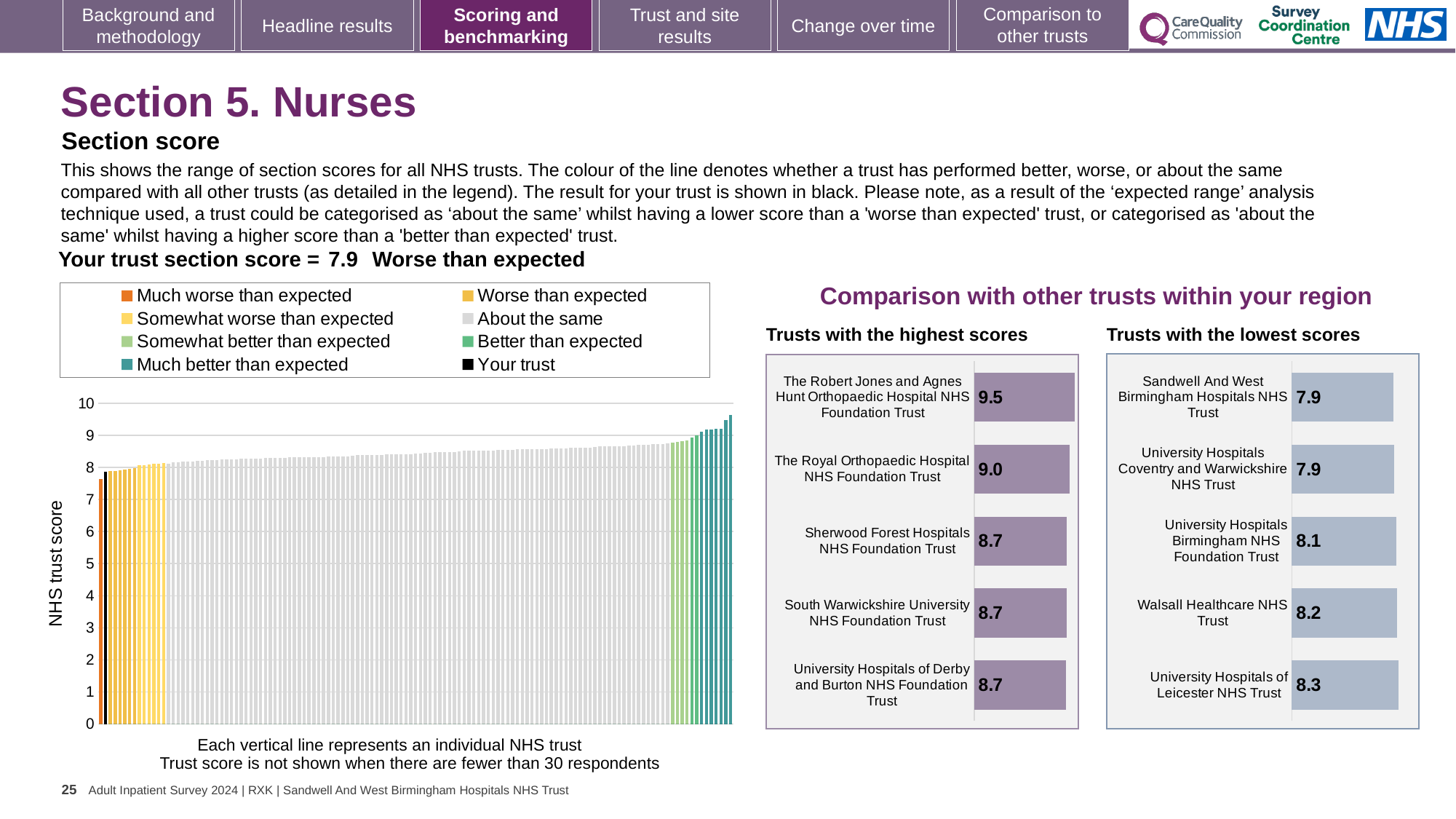
How many entries does the legend above the large chart on the left list? 8 In the large chart on the left, do the trust scores rise or fall from left to right? Rise What is the y-axis label of the large chart on the left? NHS trust score In the 'Trusts with the lowest scores' chart, which has the larger score: University Hospitals Birmingham NHS Foundation Trust or Walsall Healthcare NHS Trust? Walsall Healthcare NHS Trust How many trusts are shown in the 'Trusts with the highest scores' chart? 5 In the large chart on the left, is the value of the tallest bar greater or less than 9? greater In the 'Trusts with the lowest scores' chart, which trust has the highest score? University Hospitals of Leicester NHS Trust In the 'Trusts with the lowest scores' chart, what is the score for Walsall Healthcare NHS Trust? 8.2 What kind of chart is the large chart on the left showing NHS trust scores? Bar chart In the 'Trusts with the highest scores' chart, what is the difference between the scores of The Robert Jones and Agnes Hunt Orthopaedic Hospital NHS Foundation Trust and The Royal Orthopaedic Hospital NHS Foundation Trust? 0.5 In the 'Trusts with the highest scores' chart, what is the score for The Robert Jones and Agnes Hunt Orthopaedic Hospital NHS Foundation Trust? 9.5 In the 'Trusts with the highest scores' chart, which trust has the highest score? The Robert Jones and Agnes Hunt Orthopaedic Hospital NHS Foundation Trust